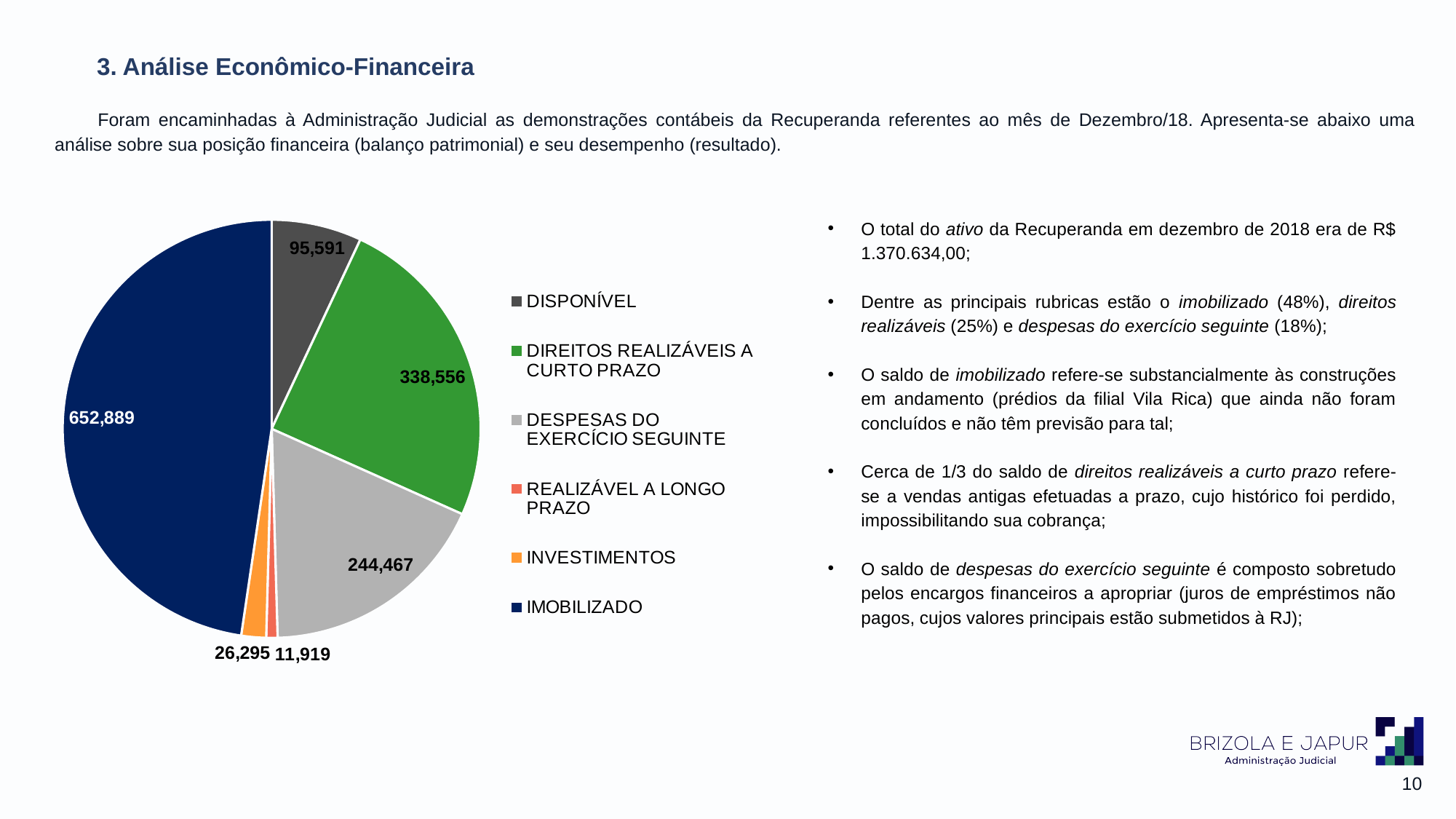
What is the value shown for DIREITOS REALIZÁVEIS A CURTO PRAZO in the pie chart? 338,556 What is the value of the IMOBILIZADO slice in the pie chart? 652,889 What type of chart is shown on the slide? Pie chart Which is larger in the pie chart: DESPESAS DO EXERCÍCIO SEGUINTE or DISPONÍVEL? DESPESAS DO EXERCÍCIO SEGUINTE What value is shown for INVESTIMENTOS in the pie chart? 26,295 Which category has the smallest slice in the pie chart? REALIZÁVEL A LONGO PRAZO What value does the pie chart show for DESPESAS DO EXERCÍCIO SEGUINTE? 244,467 What is the difference between the INVESTIMENTOS value and the REALIZÁVEL A LONGO PRAZO value? 14,376 How many categories does the pie chart legend list? 6 What is the difference between the IMOBILIZADO value and the DIREITOS REALIZÁVEIS A CURTO PRAZO value? 314,333 What is the value of the DISPONÍVEL slice? 95,591 Which category has the largest slice in the pie chart? IMOBILIZADO